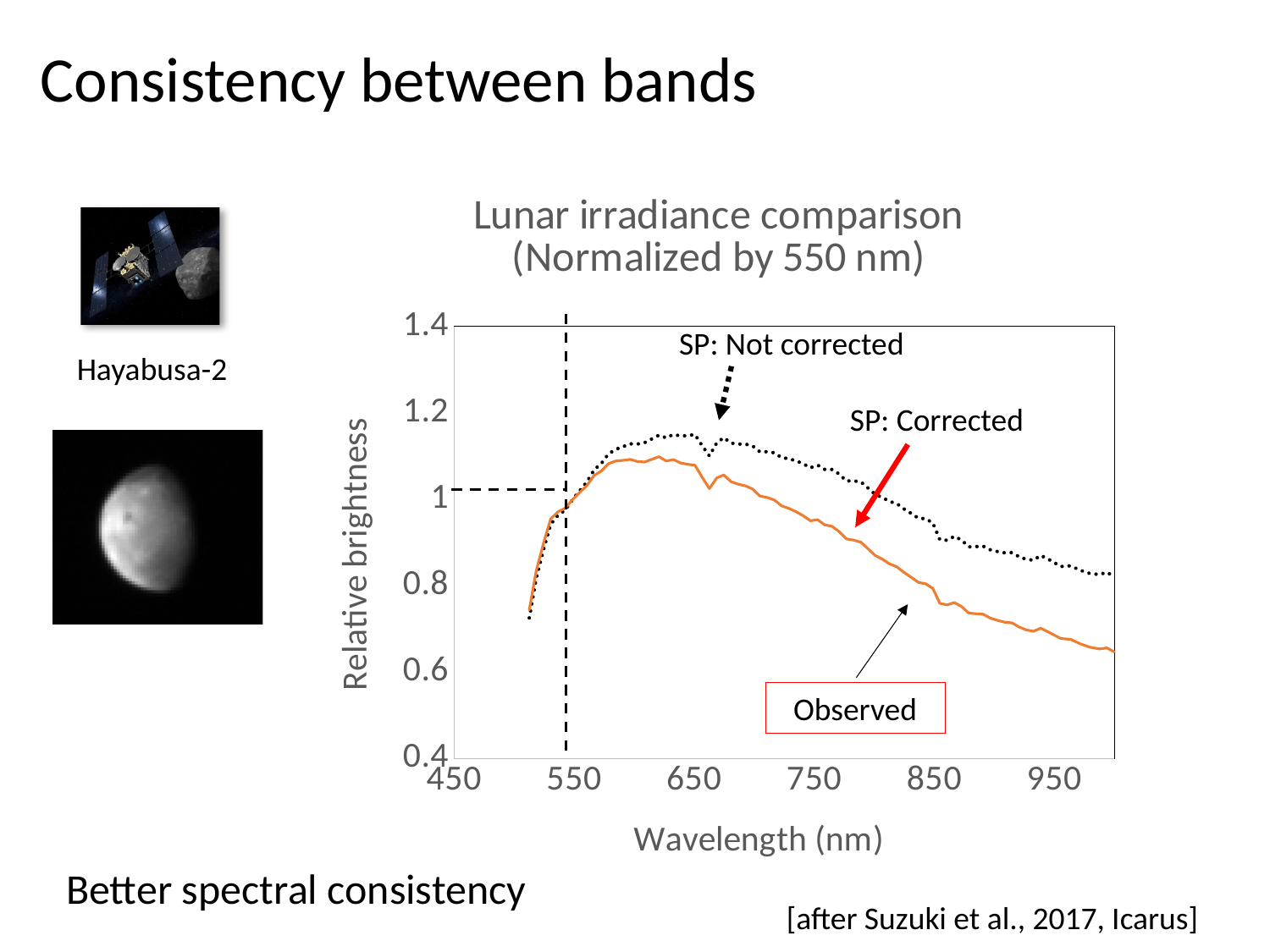
At 850 nm, which curve has the higher relative brightness, SP: Corrected or SP: Not corrected? SP: Not corrected What type of chart is shown on the slide? line chart What is the relative brightness of the curves at 550 nm, where the dashed lines cross? 1 Does the relative brightness of the SP: Not corrected curve rise or fall as wavelength increases from 500 nm to 600 nm? rise What is the label of the x axis of the chart? Wavelength (nm) What is the title of the chart? Lunar irradiance comparison (Normalized by 550 nm) What is the lowest value shown on the y axis of the chart? 0.4 Is the relative brightness of the SP: Corrected curve at 950 nm greater or less than 0.8? less Is the relative brightness of the SP: Not corrected curve at 750 nm greater or less than 1? greater How many lines are plotted on the chart? 2 Is the relative brightness of the SP: Not corrected curve at 650 nm greater or less than 1? greater Does the relative brightness of the SP: Corrected curve rise or fall as wavelength increases from 650 nm to 950 nm? fall